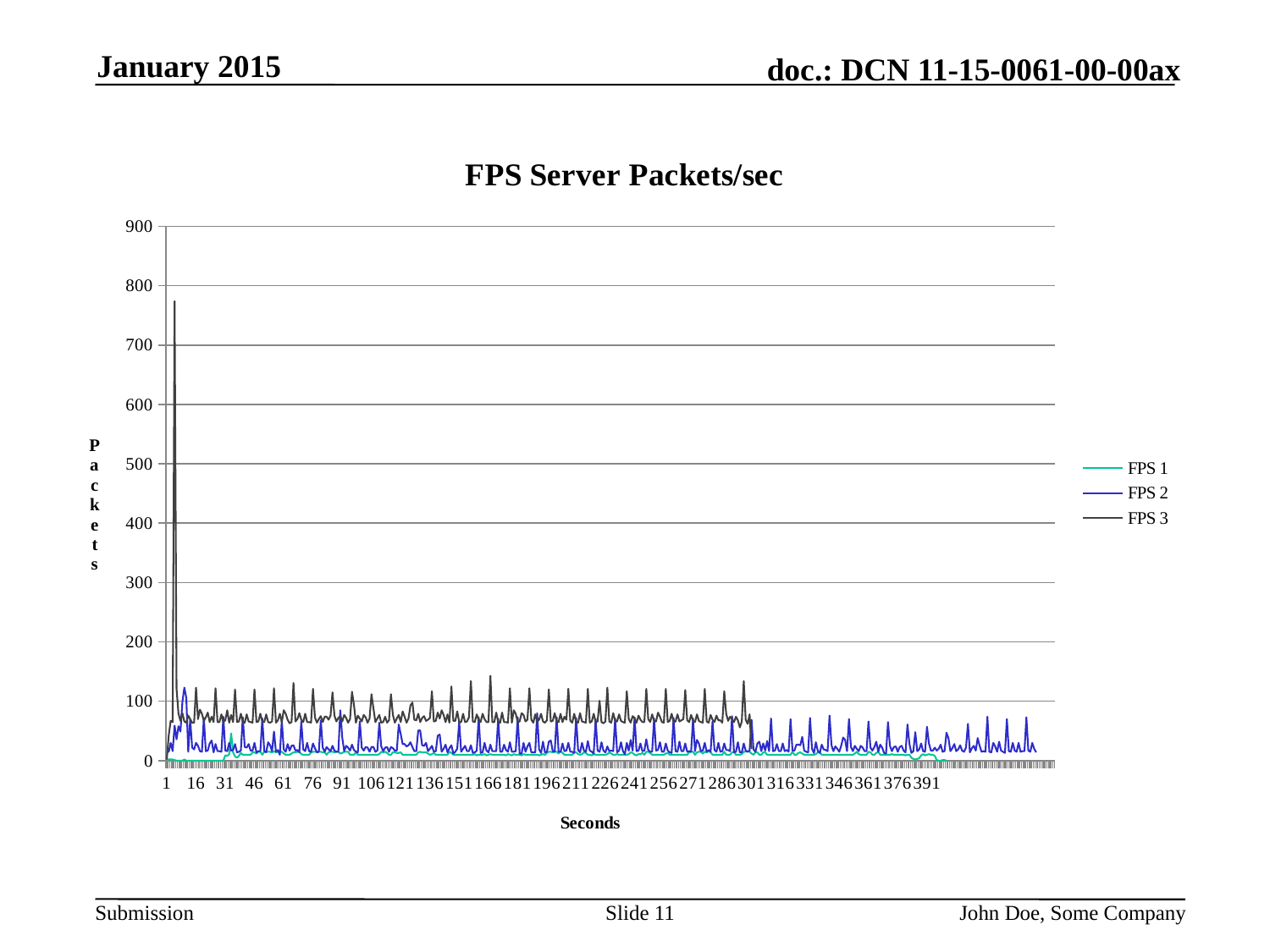
Is the highest peak of FPS 3 greater or less than 700? greater What is the title of the chart? FPS Server Packets/sec How many series does the legend list? 3 What is the label of the x axis? Seconds Does the FPS 3 series rise or fall after its initial spike near the start of the x axis? fall Which series stays lowest across the chart? FPS 1 Which series reaches the highest peak value on the chart? FPS 3 What is the highest value shown on the y axis? 900 Is the highest peak of FPS 2 greater or less than 200? less Which series has larger values over most of the chart, FPS 3 or FPS 1? FPS 3 What kind of chart is shown on the slide? line chart Is the highest peak of FPS 1 greater or less than 100? less